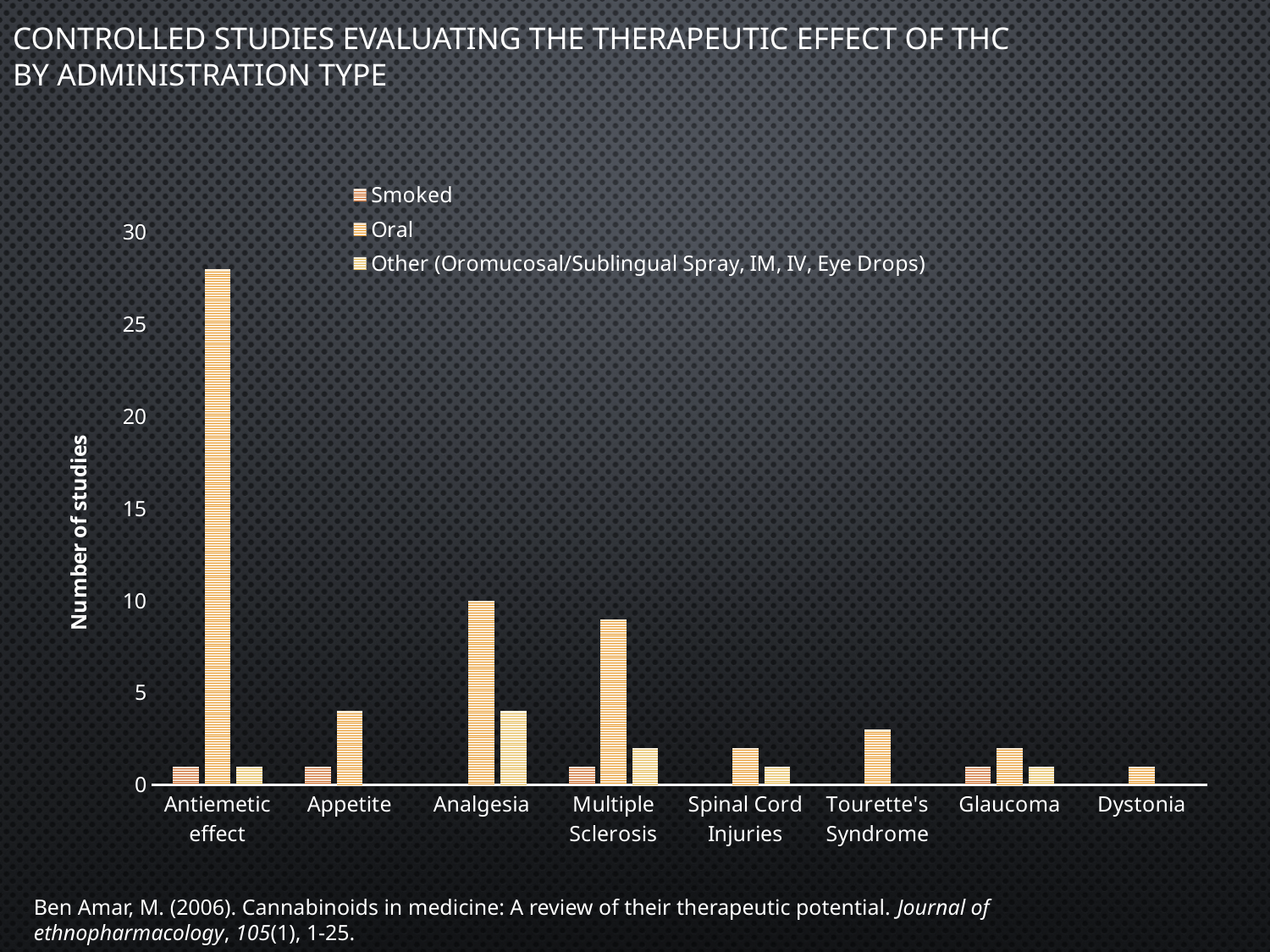
Is the Oral value for Antiemetic effect greater or less than 25? greater What is the Oral value for Analgesia? 10 Is the Oral value for Multiple Sclerosis greater or less than 10? less What type of chart is shown on the slide? bar chart Is the Oral value for Appetite greater or less than 5? less Which is larger, the Oral value for Antiemetic effect or the Oral value for Analgesia? Antiemetic effect What is the third legend entry? Other (Oromucosal/Sublingual Spray, IM, IV, Eye Drops) Which category has the highest Oral value? Antiemetic effect What is the title of the y axis? Number of studies How many series does the legend list? 3 Which is larger, the Oral value for Appetite or the Oral value for Spinal Cord Injuries? Appetite How many categories are shown on the x axis? 8